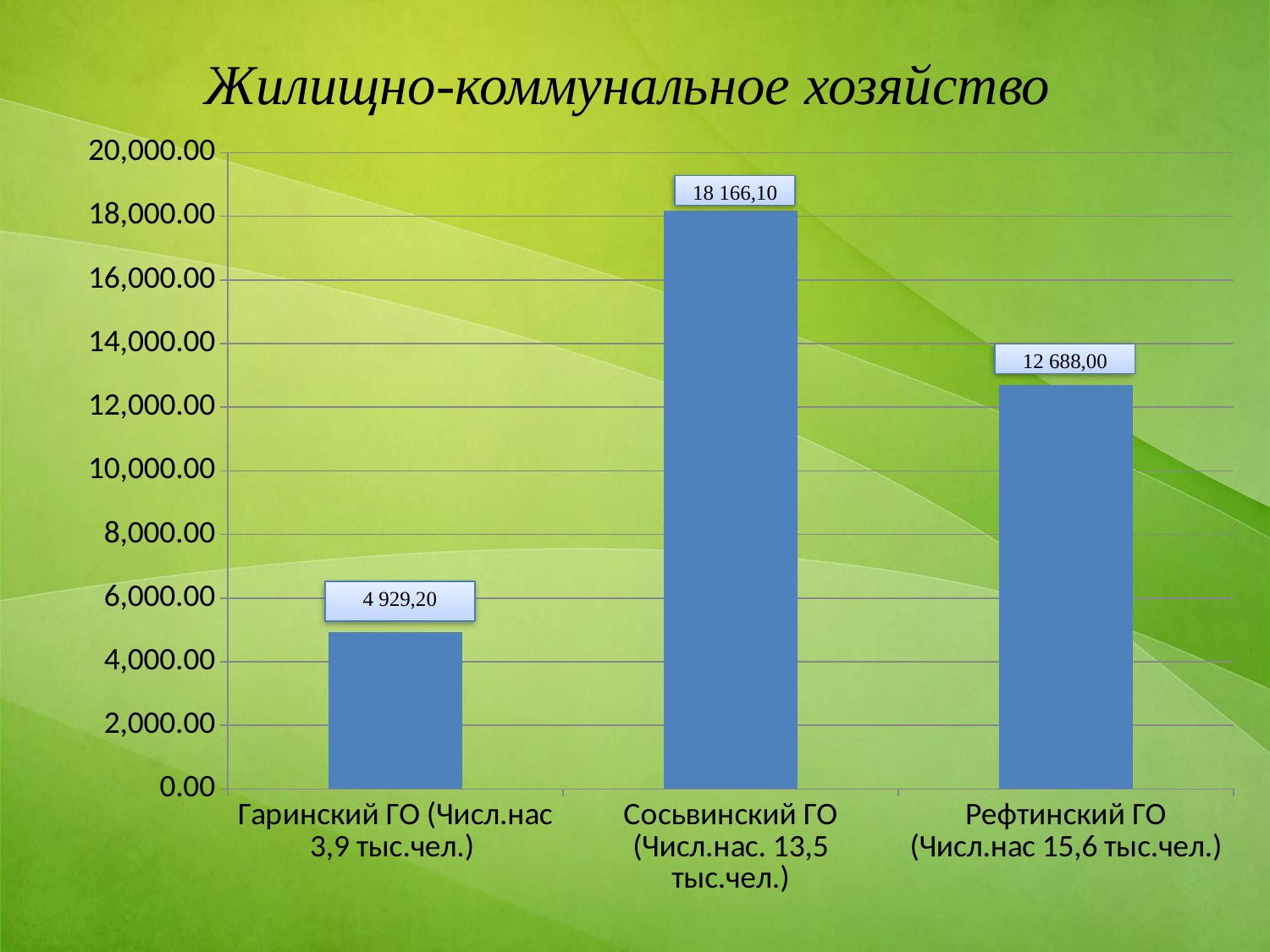
What is the value for Рефтинский ГО? 12 688,00 What is the value for Сосьвинский ГО? 18 166,10 What is the title of the chart? Жилищно-коммунальное хозяйство How many categories are shown in the chart? 3 What kind of chart is shown on the slide? bar chart What is the difference between the values for Сосьвинский ГО and Гаринский ГО? 13 236,90 Which category has the lowest value? Гаринский ГО Which is larger, the value for Рефтинский ГО or the value for Гаринский ГО? Рефтинский ГО Is the value for Рефтинский ГО greater or less than 14,000.00? less What is the difference between the values for Сосьвинский ГО and Рефтинский ГО? 5 478,10 Which category has the highest value? Сосьвинский ГО What is the value for Гаринский ГО? 4 929,20